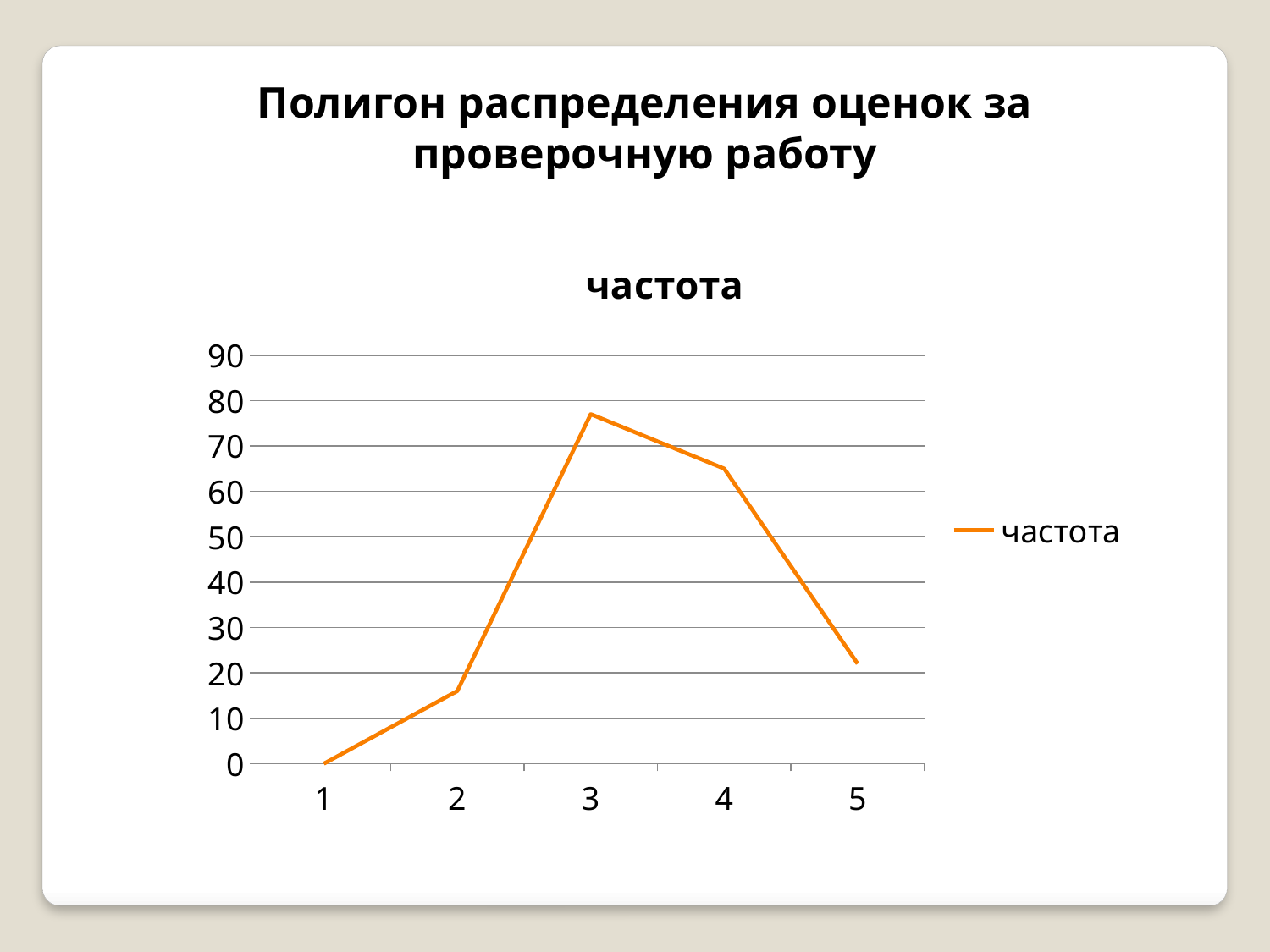
What kind of chart is shown on the slide? line chart Which category has the lowest value for частота? 1 Do the values rise or fall from category 3 to category 5? fall Is the value for category 5 greater or less than 30? less What is the value of частота for category 1? 0 Which is larger, the value for category 4 or the value for category 5? 4 How many categories are shown on the x axis? 5 Is the value for category 2 greater or less than 20? less Is the value for category 3 greater or less than 70? greater How many series does the legend list? 1 What is the name of the series shown in the legend? частота Which category has the highest value for частота? 3